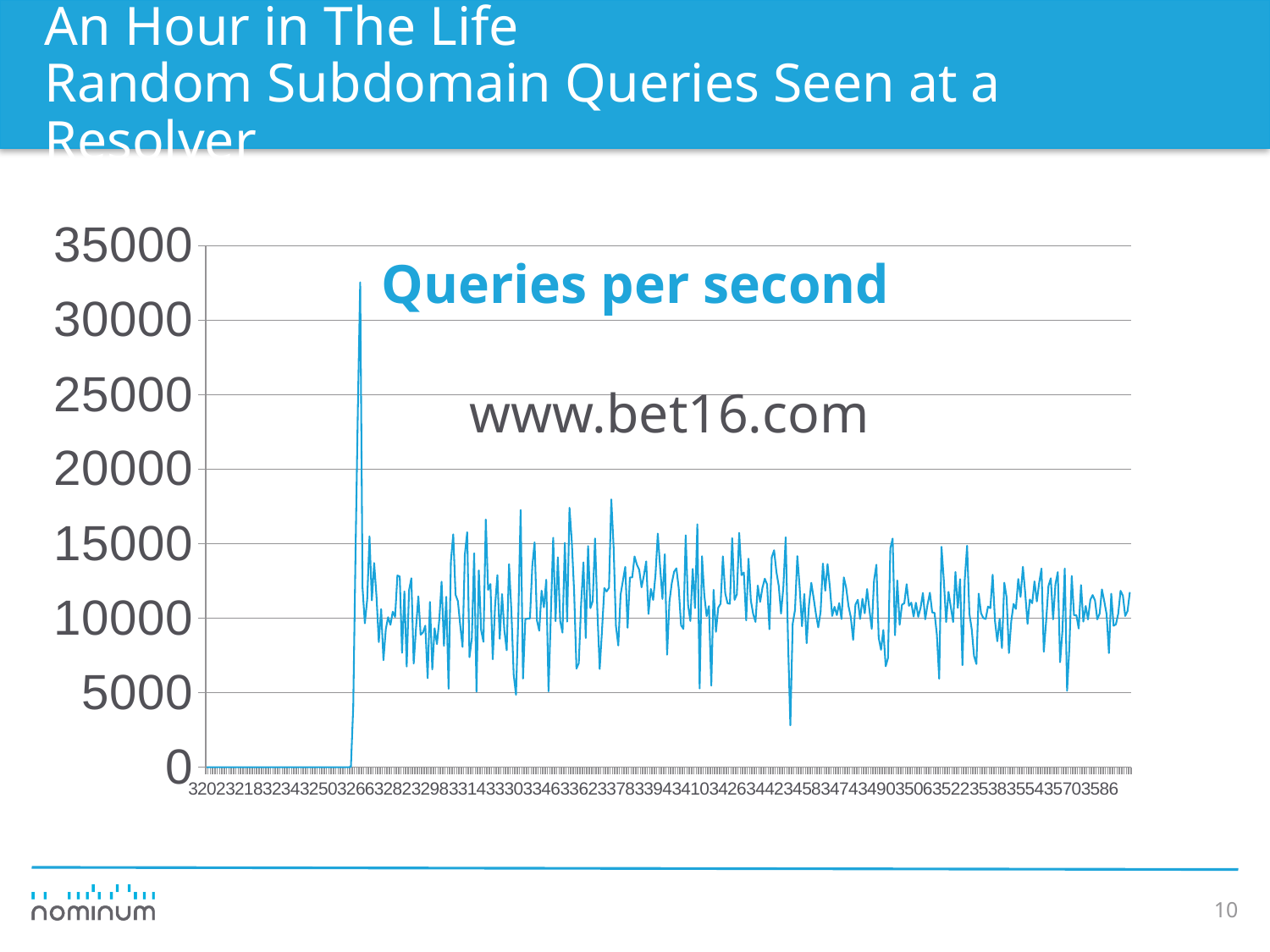
Is the highest peak of the line greater or less than 30000? greater Is the value at the initial spike larger or smaller than the values that follow it? larger After the initial spike, are most of the plotted values greater or less than 20000? less What is the highest value shown on the y axis? 35000 What is the title printed inside the chart? Queries per second Is the value of the line at the very start of the x axis greater or less than 5000? less Which domain name is printed inside the chart area? www.bet16.com What kind of chart is shown on the slide? line chart